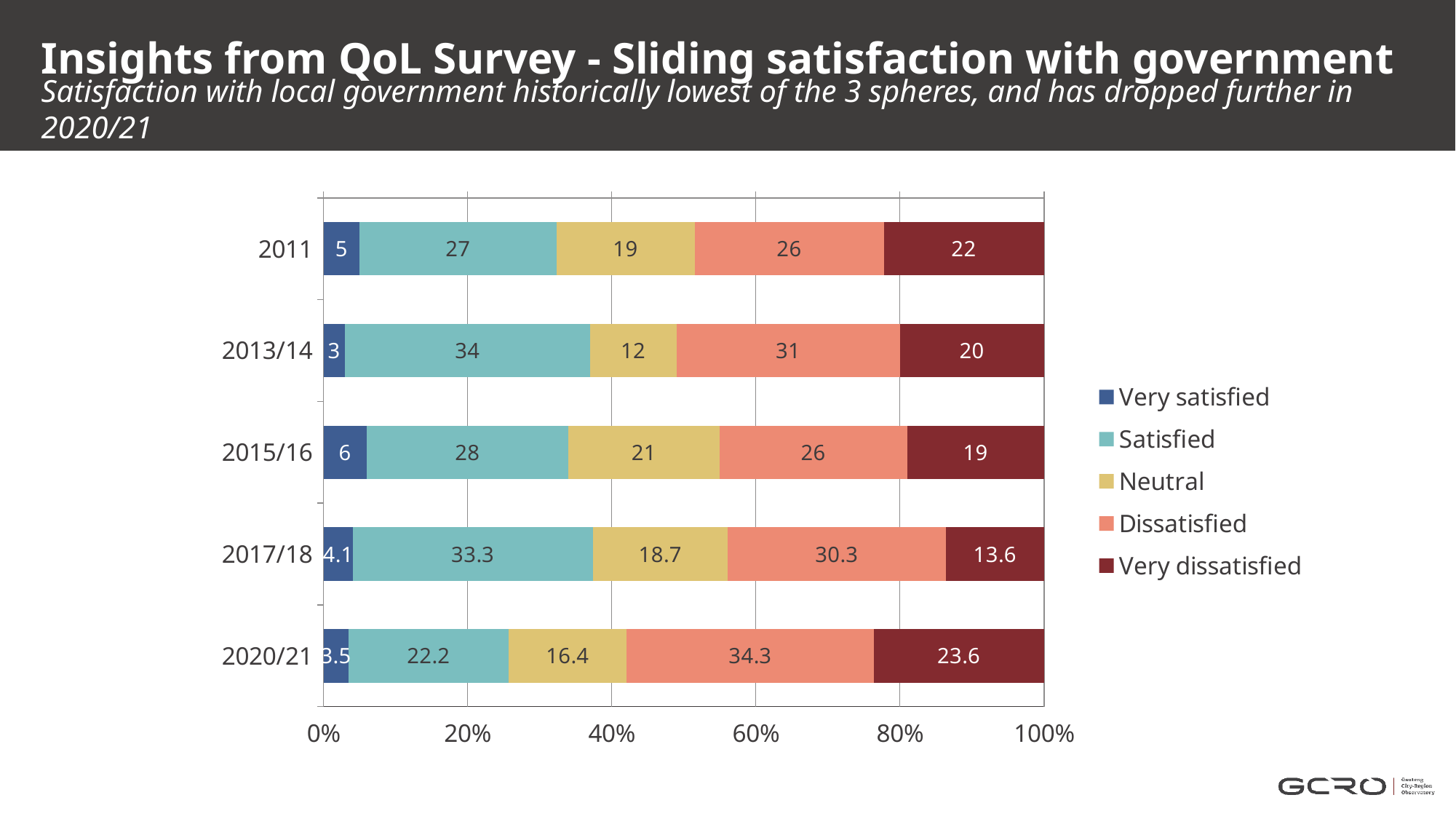
Which year has the lowest value for Very dissatisfied? 2017/18 Which year has the highest value for Satisfied? 2013/14 How many survey years are shown on the chart? 5 How many series does the legend list? 5 What is the value for Satisfied in 2013/14? 34 Which is larger, the Neutral value in 2015/16 or in 2011? 2015/16 What is the value for Very dissatisfied in 2020/21? 23.6 What is the value for Dissatisfied in 2017/18? 30.3 What is the difference between the Dissatisfied value in 2020/21 and in 2011? 8.3 Which year has the highest value for Dissatisfied? 2020/21 What kind of chart is shown on the slide? Stacked bar chart Does the Satisfied value rise or fall from 2017/18 to 2020/21? Fall